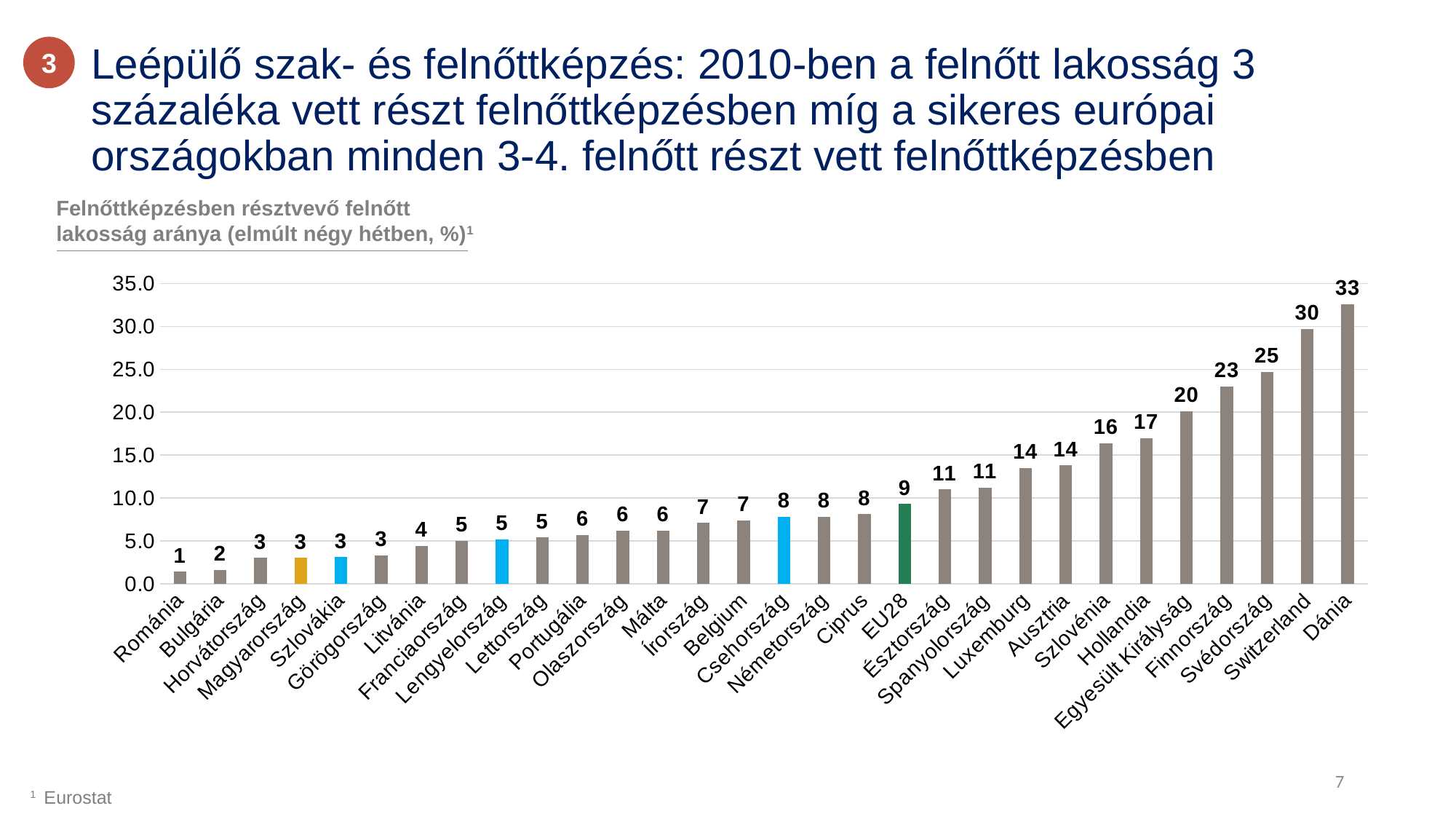
What is the value for Dánia? 33 What kind of chart is shown on the slide? bar chart Which country has the highest value? Dánia Which has a larger value, Finnország or Svédország? Svédország What colour is the bar for Magyarország? orange How many countries/categories are shown on the chart? 30 What is the value for EU28? 9 What is the value for Magyarország? 3 Do the values rise or fall from left to right along the x axis? rise Which country has the lowest value? Románia Is the value for Switzerland greater or less than 25? greater What is the difference between the values for Dánia and Magyarország? 30